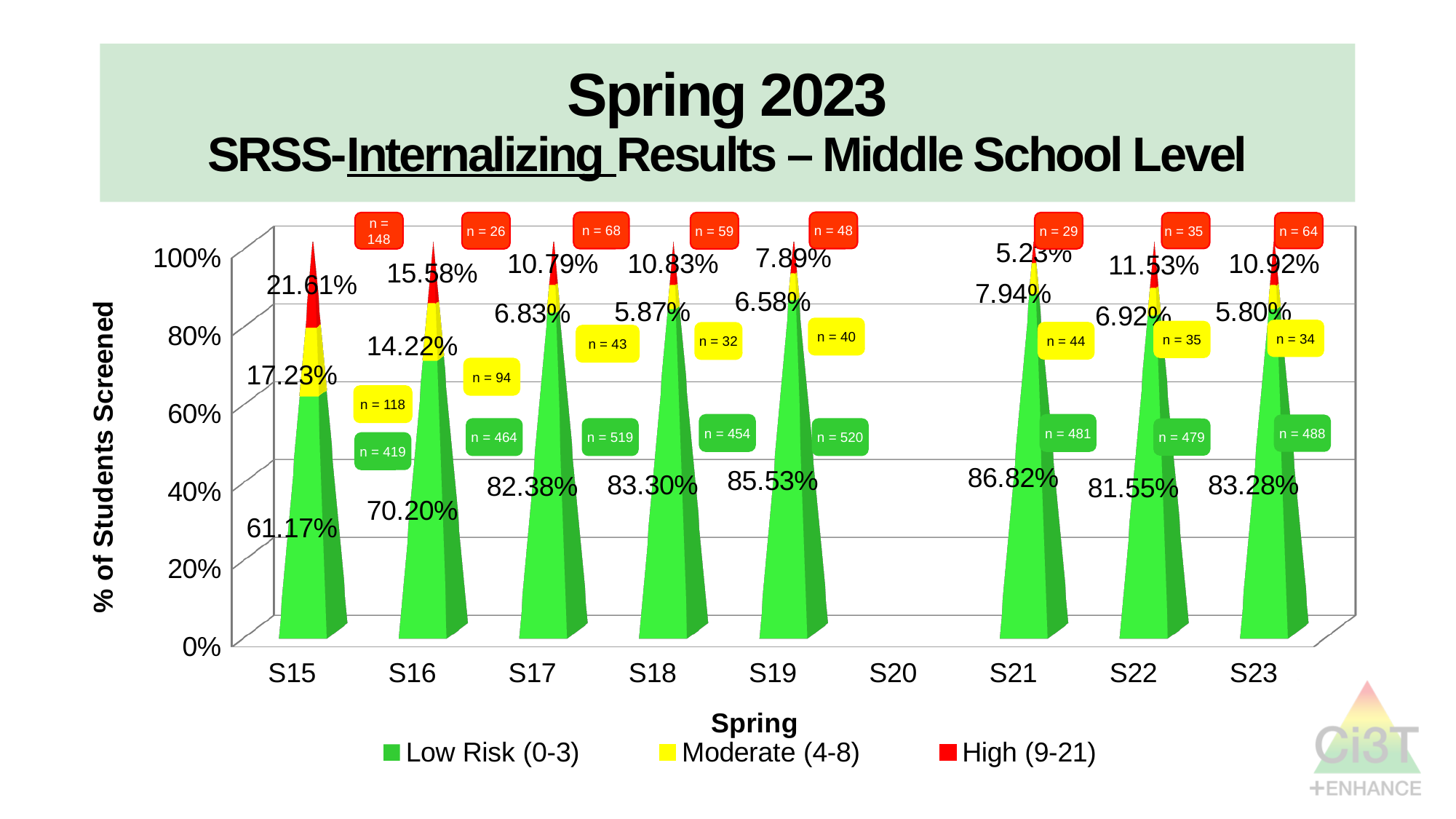
What colour represents the High (9-21) series in the legend? Red What is the Moderate (4-8) percentage for S19? 6.58% Does the Low Risk (0-3) percentage rise or fall from S15 to S19? Rise How many springs are labelled on the x axis? 9 What kind of chart is shown on the slide? Stacked bar chart Which spring has the highest Low Risk (0-3) percentage? S21 What is the Low Risk (0-3) percentage for S15? 61.17% What is the difference between the Low Risk (0-3) percentages for S16 and S15? 9.03% What is the High (9-21) percentage for S22? 11.53% Which spring has the lowest Low Risk (0-3) percentage? S15 Which is larger, the High (9-21) percentage for S15 or for S16? S15 How many series does the legend list? 3